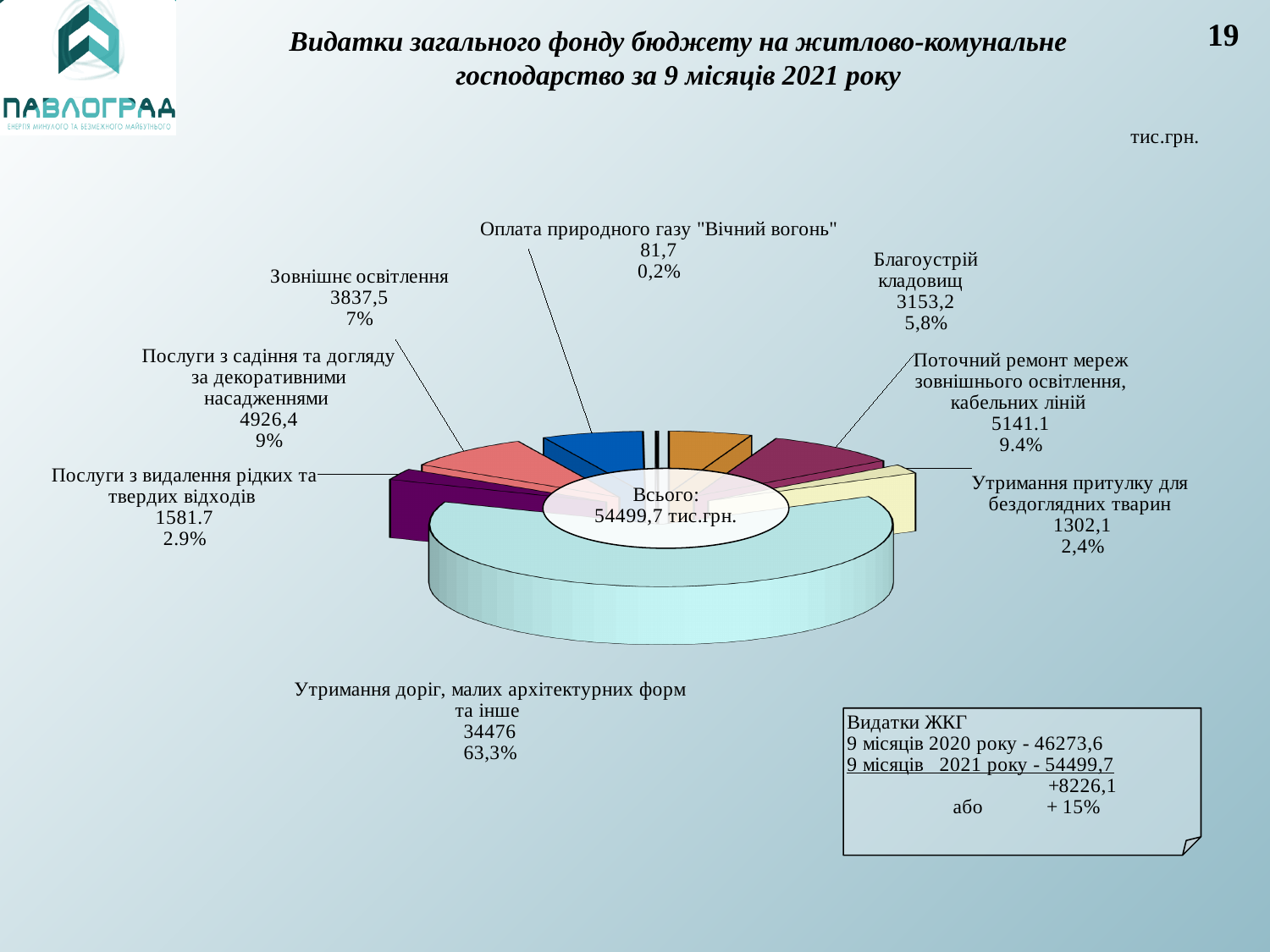
What is the value for "Зовнішнє освітлення"? 3837,5 What is the value for "Утримання притулку для бездоглядних тварин"? 1302,1 What share of the pie does "Послуги з садіння та догляду за декоративними насадженнями" represent? 9% How many categories (slices) does the pie chart have? 8 What share of the pie does "Утримання доріг, малих архітектурних форм та інше" represent? 63,3% Which category has the smallest share of the pie? Оплата природного газу "Вічний вогонь" What kind of chart is shown on the slide? pie chart Which is larger: the value for "Зовнішнє освітлення" or the value for "Благоустрій кладовищ"? Зовнішнє освітлення Which category has the largest share of the pie? Утримання доріг, малих архітектурних форм та інше What is the value for "Благоустрій кладовищ"? 3153,2 What total value is shown in the centre of the pie chart? 54499,7 тис.грн. What is the value for "Поточний ремонт мереж зовнішнього освітлення, кабельних ліній"? 5141.1